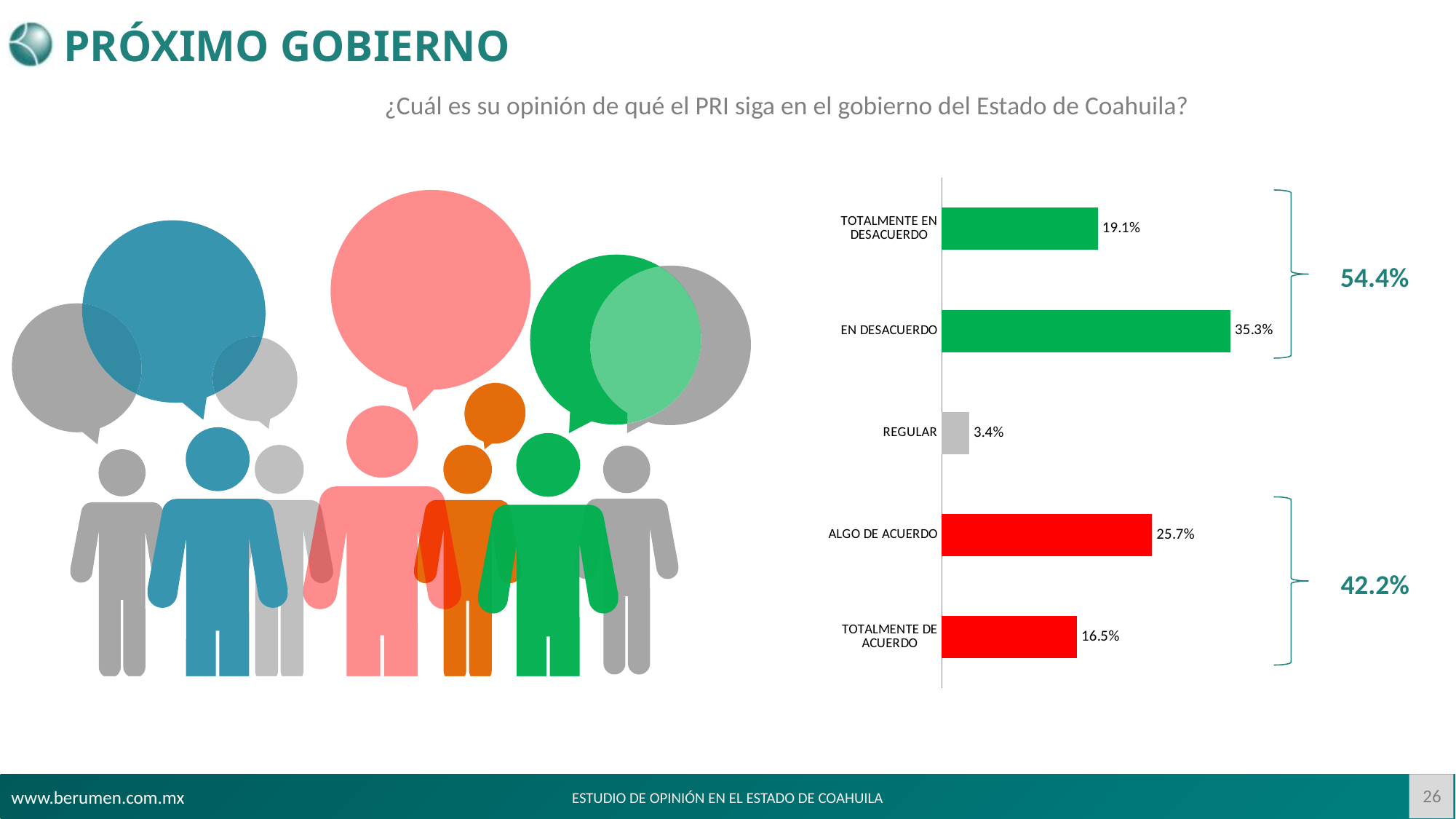
What is the value for TOTALMENTE DE ACUERDO? 16.5% How many categories are shown in the chart? 5 What is the difference between EN DESACUERDO and TOTALMENTE EN DESACUERDO? 16.2% Which is larger, ALGO DE ACUERDO or TOTALMENTE EN DESACUERDO? ALGO DE ACUERDO What is the value for ALGO DE ACUERDO? 25.7% What combined percentage is shown for the two 'desacuerdo' categories? 54.4% What kind of chart is shown on the slide? bar chart What colour are the bars for ALGO DE ACUERDO and TOTALMENTE DE ACUERDO? red What is the value for EN DESACUERDO? 35.3% Which category has the lowest value? REGULAR Which category has the highest value? EN DESACUERDO What is the value for REGULAR? 3.4%